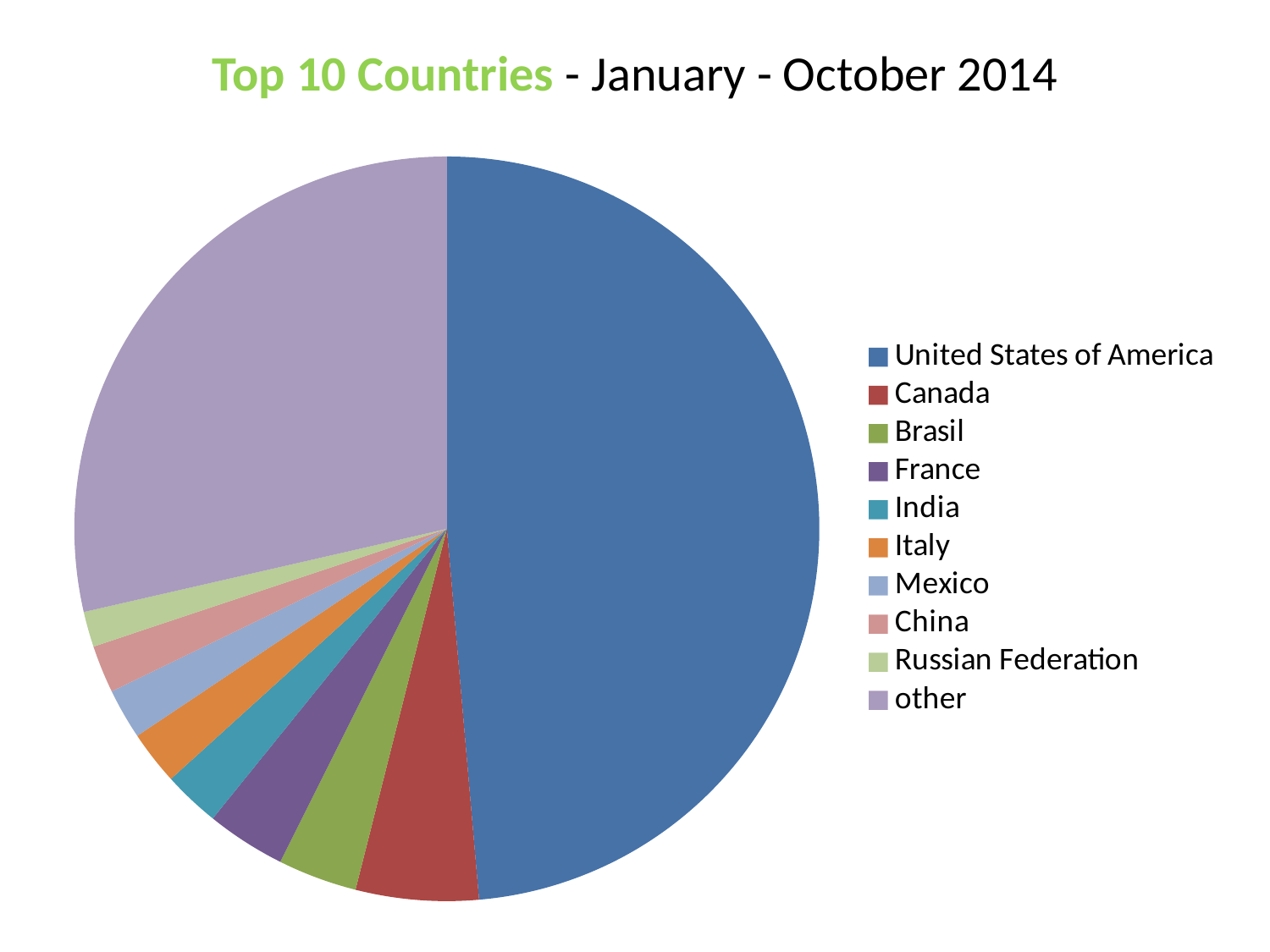
Which slice is larger, other or Canada? other Which category has the smallest slice of the pie? Russian Federation What colour is the slice for United States of America? Blue How many entries does the legend list? 10 Which category has the largest slice of the pie? United States of America What is the title of the chart? Top 10 Countries - January - October 2014 How many slices does the pie chart have? 10 What kind of chart is shown on the slide? Pie chart Which slice is larger, Mexico or Russian Federation? Mexico Which slice is larger, Canada or Brasil? Canada